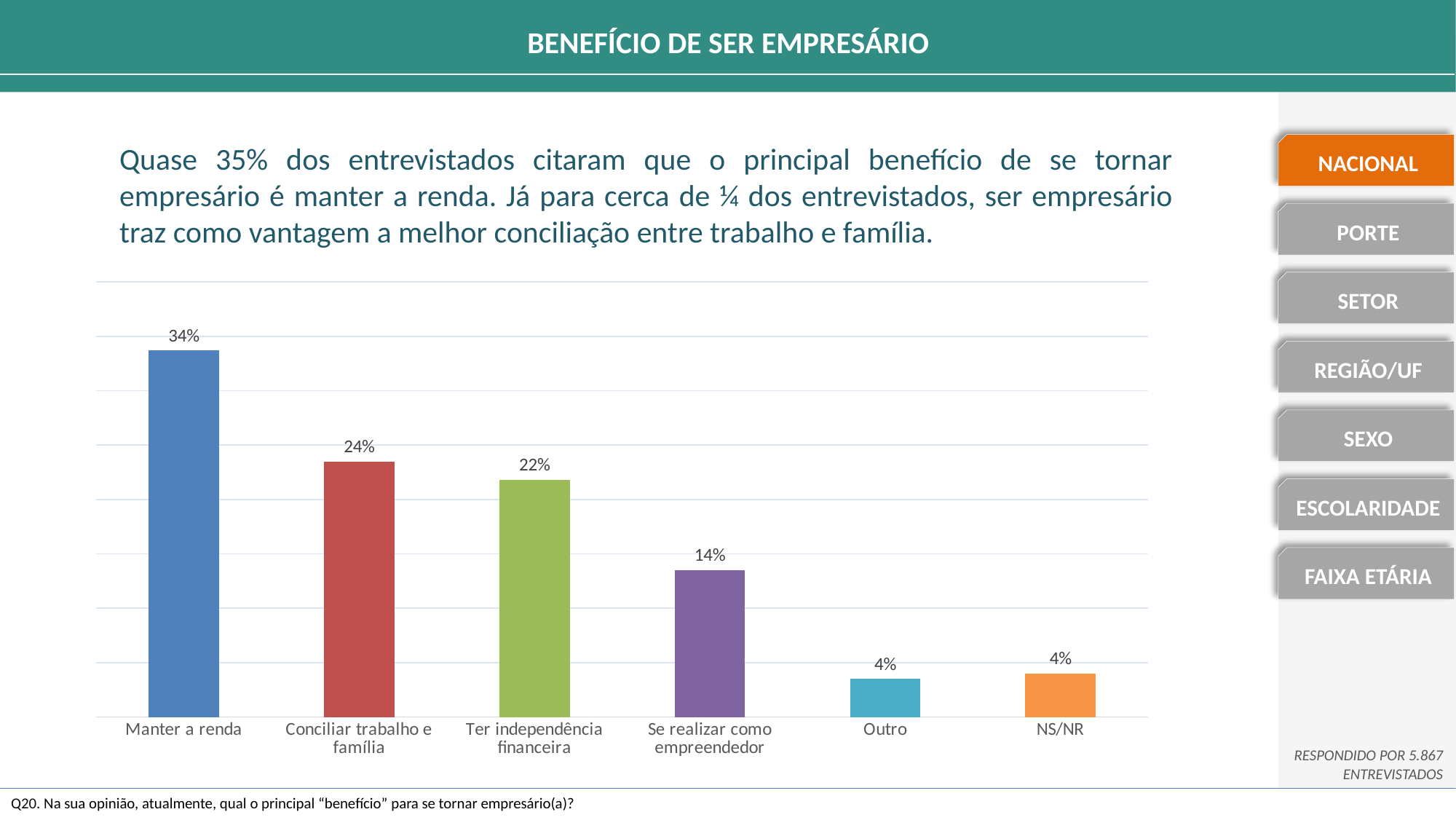
What is the value for "Conciliar trabalho e família"? 24% Which category has the highest value? Manter a renda What is the title of the slide? BENEFÍCIO DE SER EMPRESÁRIO How many categories are shown in the chart? 6 What is the value for "Se realizar como empreendedor"? 14% Which is larger, "Conciliar trabalho e família" or "Ter independência financeira"? Conciliar trabalho e família What is the value for "Outro"? 4% What is the value for "Manter a renda"? 34% What is the difference between "Ter independência financeira" and "Se realizar como empreendedor"? 8% What kind of chart is shown on the slide? Bar chart What is the difference between "Manter a renda" and "Conciliar trabalho e família"? 10% What is the value for "Ter independência financeira"? 22%